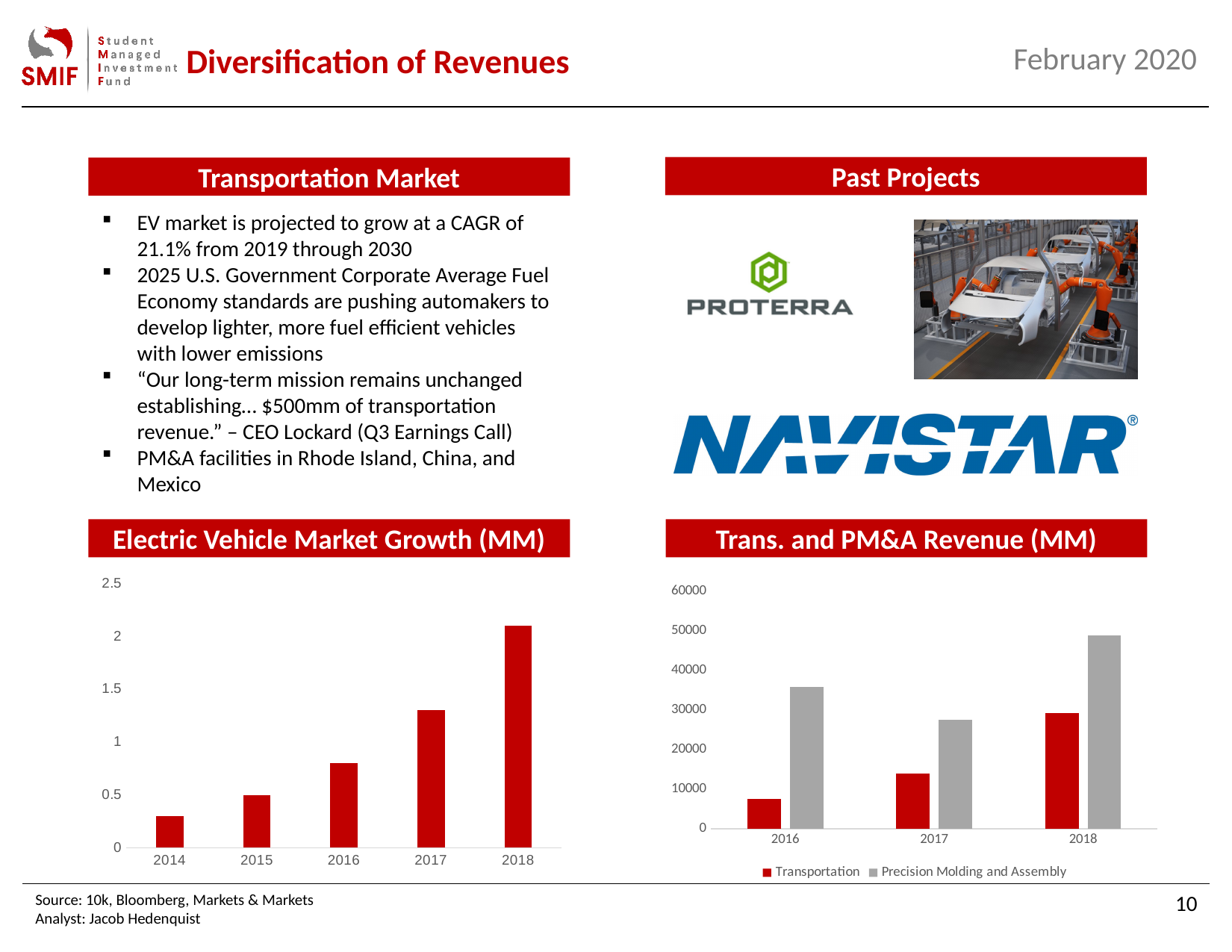
In the Trans. and PM&A Revenue (MM) chart, how many series does the legend list? 2 In the Electric Vehicle Market Growth (MM) chart, is the value for 2018 greater or less than 2? greater In the Electric Vehicle Market Growth (MM) chart, do the values rise or fall from 2014 to 2018? rise In the Trans. and PM&A Revenue (MM) chart, is the Transportation value for 2016 greater or less than 10000? less What kind of chart is the Trans. and PM&A Revenue (MM) chart? bar chart In the Trans. and PM&A Revenue (MM) chart, which is larger in 2017: Transportation or Precision Molding and Assembly? Precision Molding and Assembly In the Trans. and PM&A Revenue (MM) chart, which year has the highest Precision Molding and Assembly value? 2018 In the Electric Vehicle Market Growth (MM) chart, which year has the lowest value? 2014 In the Electric Vehicle Market Growth (MM) chart, which year has the highest value? 2018 In the Trans. and PM&A Revenue (MM) chart, what colour are the Transportation bars? red In the Electric Vehicle Market Growth (MM) chart, how many years are plotted? 5 In the Electric Vehicle Market Growth (MM) chart, is the value for 2016 greater or less than 1? less